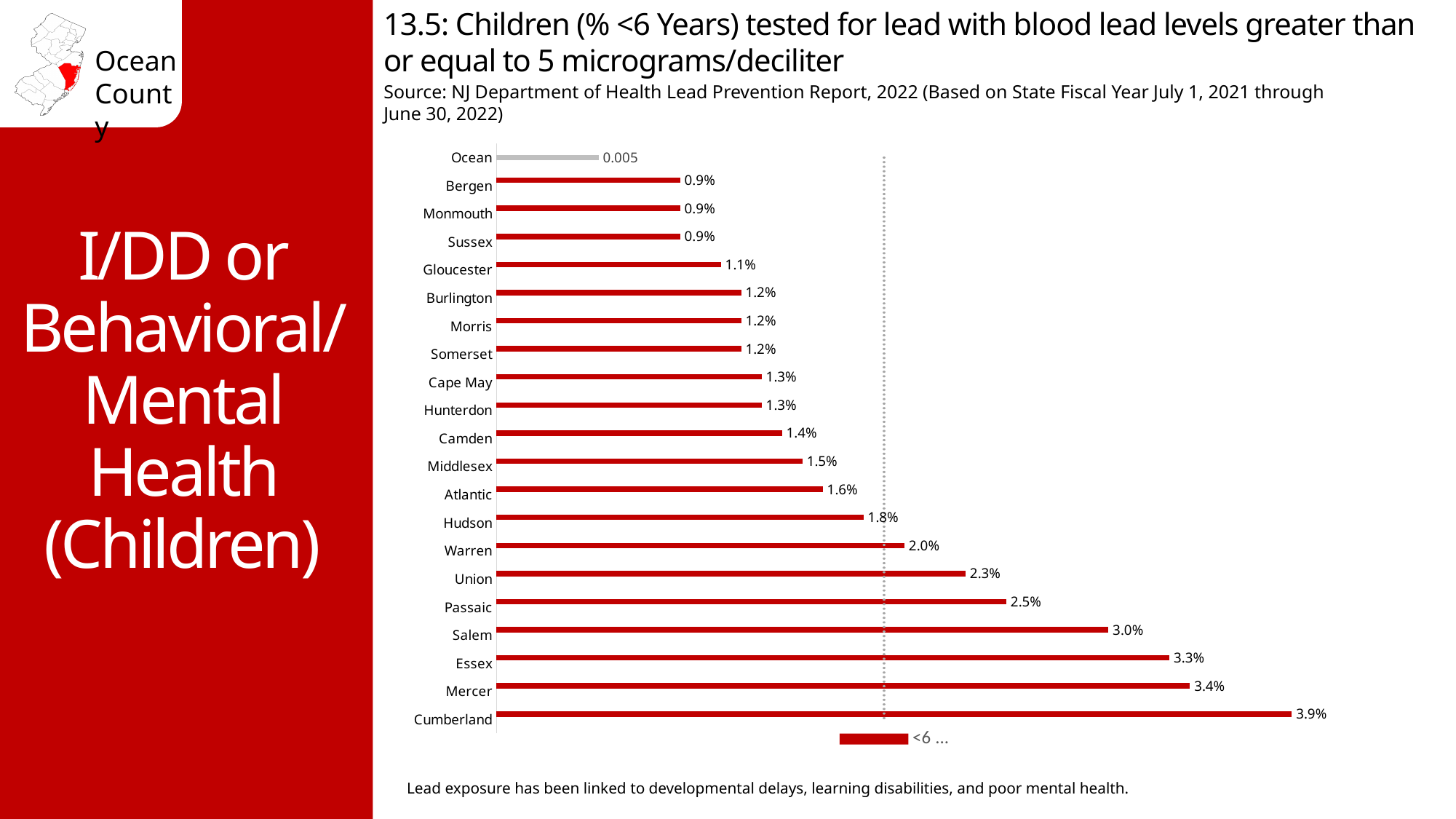
Which county has the shortest bar? Ocean What value is shown for Ocean? 0.005 Do the values increase or decrease going from the top of the chart to the bottom? Increase Which county has the highest value? Cumberland Which is larger, the value for Union or the value for Warren? Union What value is shown for Passaic? 2.5% What is the difference between the values for Cumberland and Mercer? 0.5 percentage points What value is shown for Cumberland? 3.9% How many counties are shown in the chart? 21 What is the difference between the values for Essex and Salem? 0.3 percentage points What value is shown for Hudson? 1.8% What kind of chart is shown on the slide? Bar chart